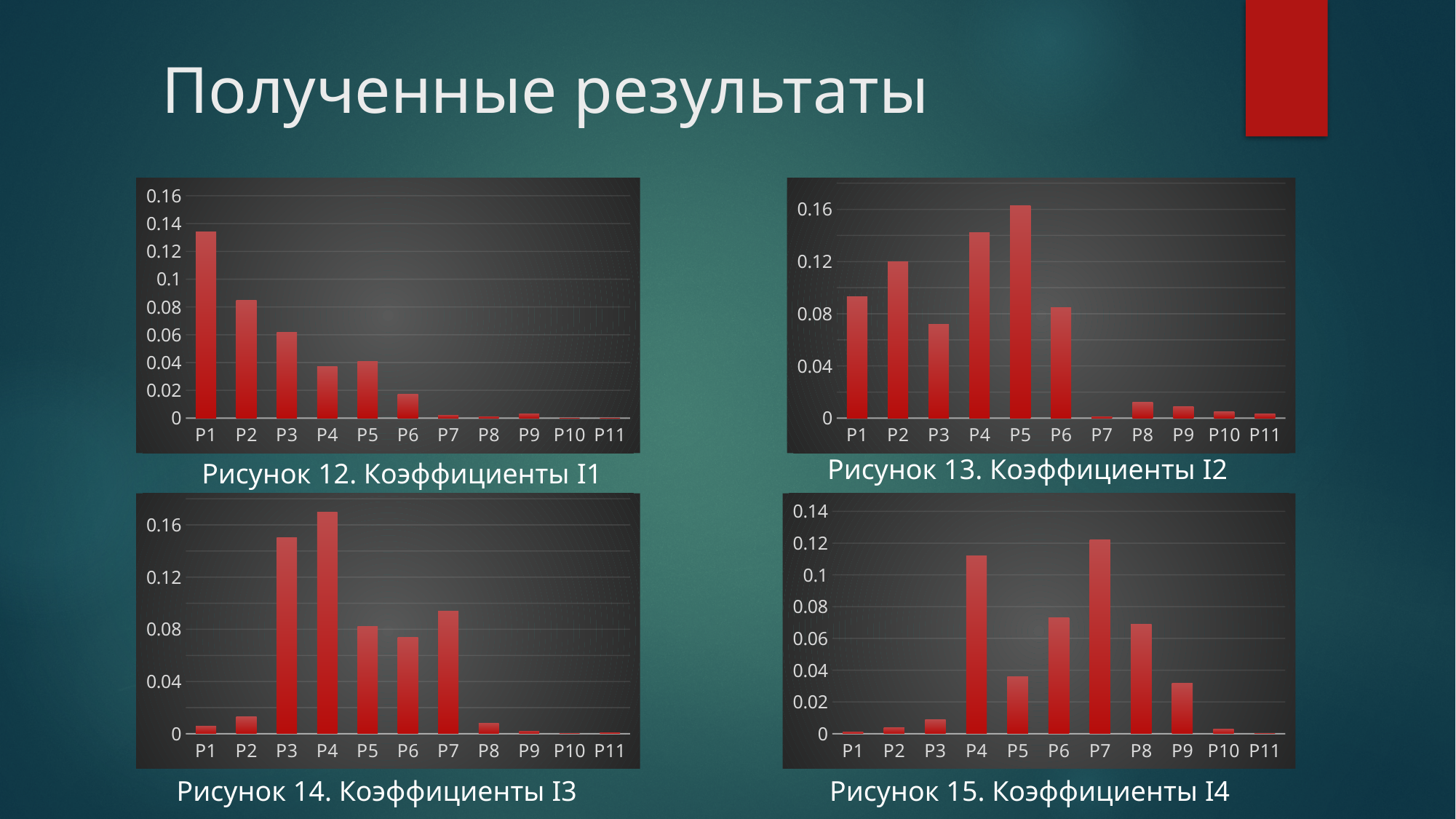
In Рисунок 15. Коэффициенты I4, is the value for P4 greater or less than 0.1? greater What kind of chart is Рисунок 12. Коэффициенты I1? bar chart In Рисунок 14. Коэффициенты I3, which category has the highest value? P4 In Рисунок 12. Коэффициенты I1, do the values generally rise or fall from P1 to P11? fall In Рисунок 12. Коэффициенты I1, which category has the highest value? P1 How many categories are shown on the x axis of Рисунок 15. Коэффициенты I4? 11 In Рисунок 15. Коэффициенты I4, which category has the highest value? P7 In Рисунок 13. Коэффициенты I2, is the value for P4 greater or less than 0.12? greater In Рисунок 12. Коэффициенты I1, is the value for P1 greater or less than 0.12? greater In Рисунок 14. Коэффициенты I3, which is larger, the value for P3 or the value for P7? P3